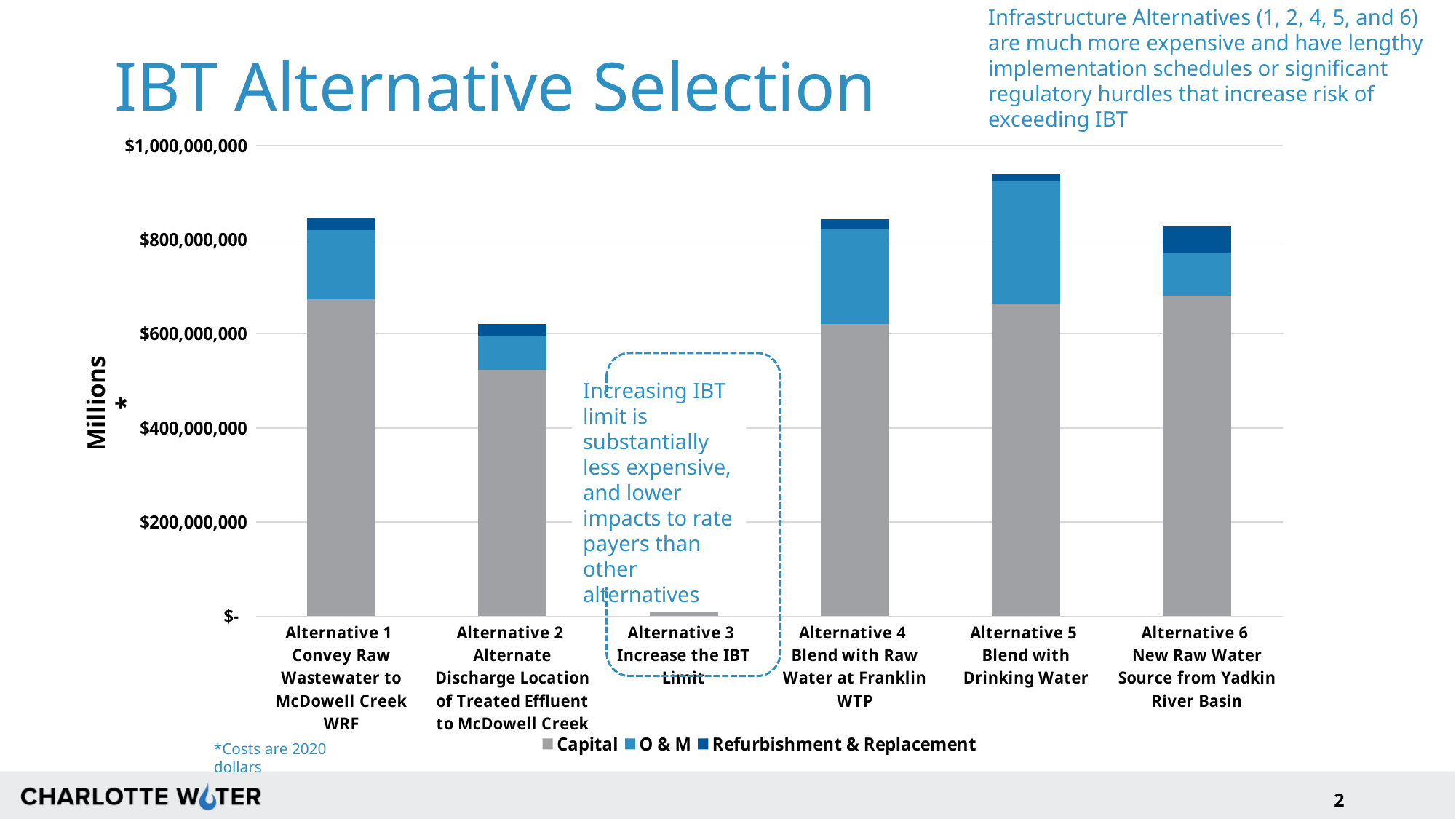
How many alternatives (categories) are plotted on the chart? 6 What kind of chart is shown on the slide? Stacked bar chart Is the total cost for Alternative 3 greater or less than $200,000,000? less Which series is shown in gray in the chart's legend? Capital How many series does the chart's legend list? 3 Is the total cost for Alternative 5 greater or less than $1,000,000,000? less Which alternative has the lowest total cost on the chart? Alternative 3 Increase the IBT Limit Which alternative has the highest total cost on the chart? Alternative 5 Blend with Drinking Water What is the title of the slide containing the chart? IBT Alternative Selection Is the Capital cost for Alternative 2 greater or less than $600,000,000? less Which has a larger total cost, Alternative 5 or Alternative 2? Alternative 5